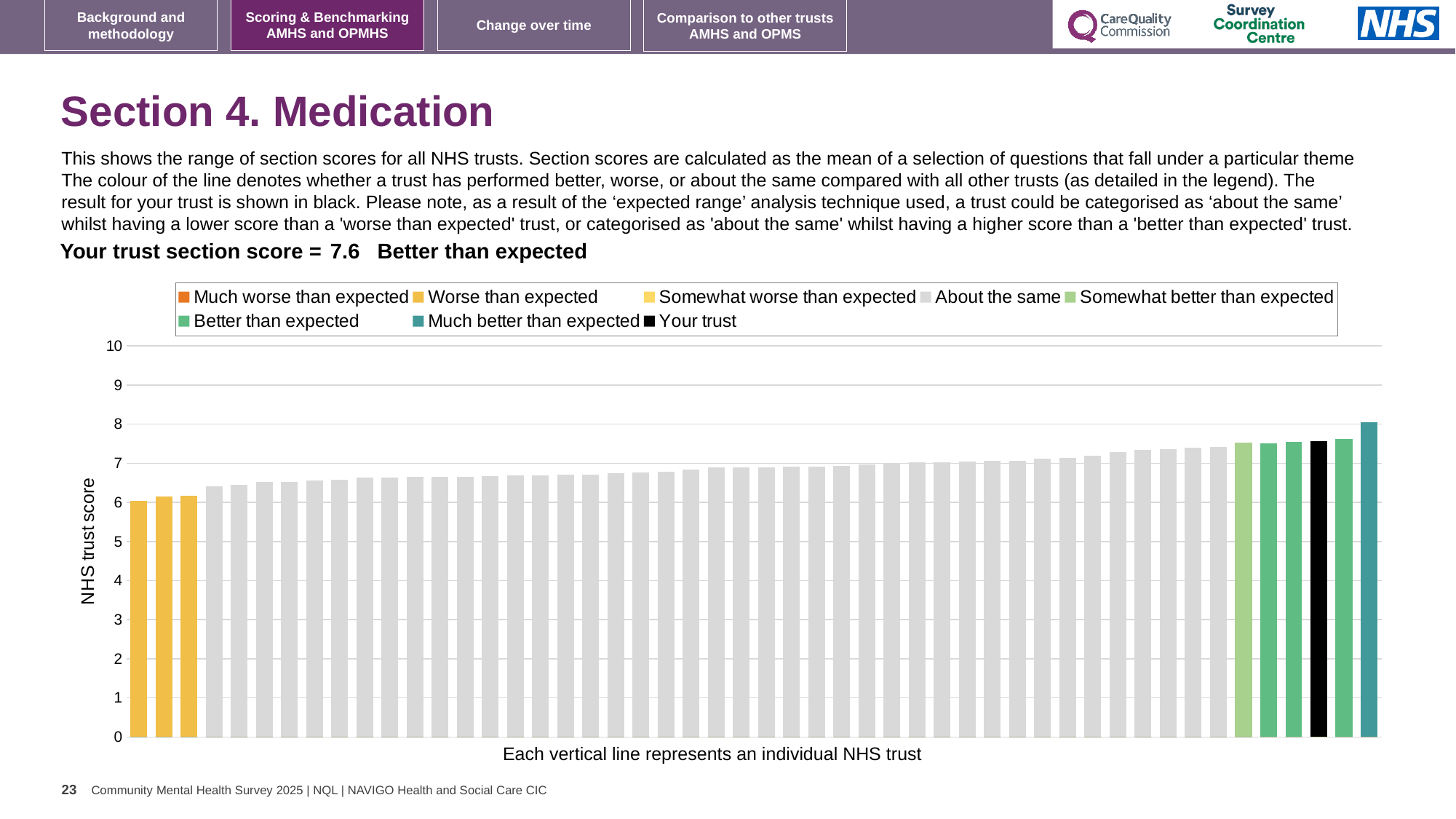
How many bars are coloured black to represent your trust? 1 Is your trust's section score greater or less than 7? greater Do the bar values rise or fall from left to right along the x axis? rise What is the label on the vertical axis of the chart? NHS trust score Which legend category does the tallest bar on the chart belong to? Much better than expected What is your trust's section score for Section 4. Medication? 7.6 How many entries does the chart legend list? 8 Is the highest bar on the chart greater or less than 9? less What kind of chart is shown on the slide? bar chart Is the lowest bar on the chart greater or less than 7? less How is your trust's section score categorised compared with other trusts? Better than expected What does each vertical line on the chart represent, according to the x-axis label? an individual NHS trust